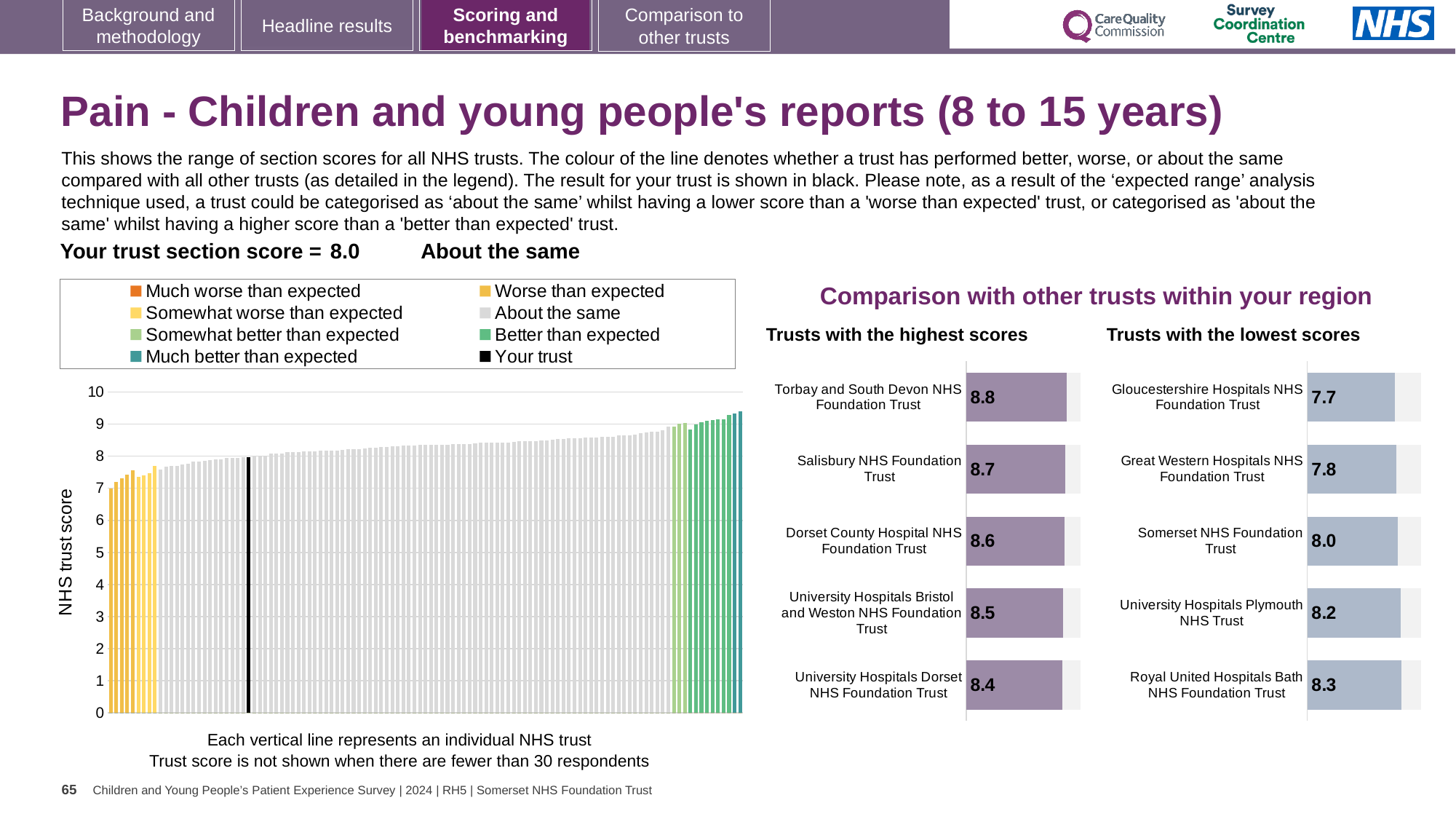
In the 'Trusts with the lowest scores' chart, what is the difference between the scores of Royal United Hospitals Bath NHS Foundation Trust and Great Western Hospitals NHS Foundation Trust? 0.5 How many entries does the legend of the left-hand NHS trust score chart list? 8 In the 'Trusts with the highest scores' chart, which has the higher score: Salisbury NHS Foundation Trust or Dorset County Hospital NHS Foundation Trust? Salisbury NHS Foundation Trust In the 'Trusts with the highest scores' chart, which trust has the highest score? Torbay and South Devon NHS Foundation Trust How many trusts are shown in the 'Trusts with the lowest scores' chart? 5 In the 'Trusts with the highest scores' chart, what is the score for Torbay and South Devon NHS Foundation Trust? 8.8 In the 'Trusts with the highest scores' chart, what is the difference between the scores of Torbay and South Devon NHS Foundation Trust and University Hospitals Dorset NHS Foundation Trust? 0.4 In the 'Trusts with the lowest scores' chart, what is the score for Somerset NHS Foundation Trust? 8.0 In the 'Trusts with the lowest scores' chart, what is the score for Gloucestershire Hospitals NHS Foundation Trust? 7.7 What kind of chart is the left-hand chart showing NHS trust scores? Bar chart In the 'Trusts with the lowest scores' chart, which trust has the lowest score? Gloucestershire Hospitals NHS Foundation Trust In the left-hand NHS trust score chart, do the values rise or fall from left to right? Rise